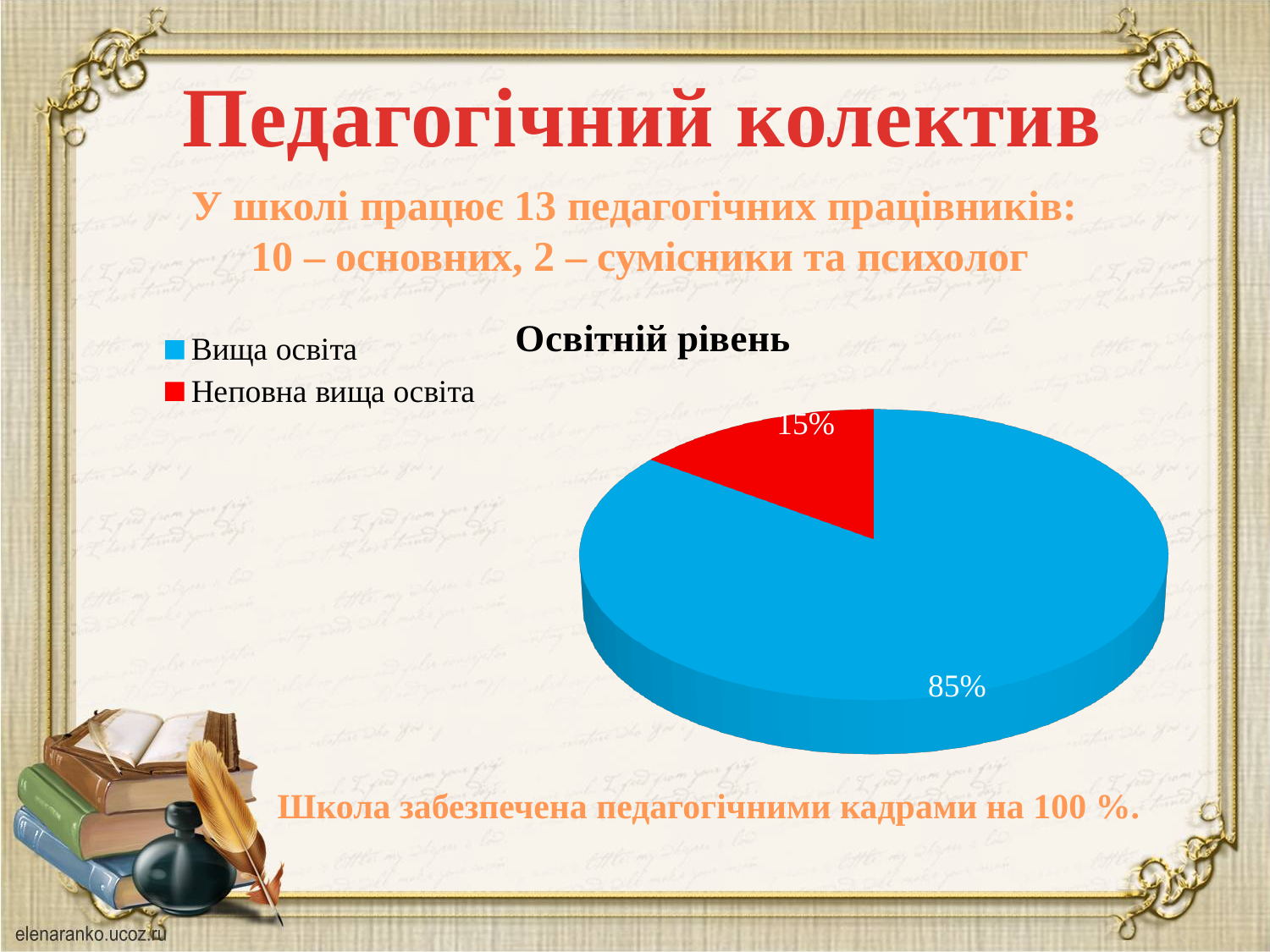
What colour is the slice for "Неповна вища освіта"? red What is the difference in percentage points between "Вища освіта" and "Неповна вища освіта"? 70 Which category has the smallest slice of the pie? Неповна вища освіта What is the title of the chart? Освітній рівень What kind of chart is shown on the slide? pie chart How many categories does the legend list? 2 What share of the pie does "Вища освіта" have? 85% Which is larger: the slice for "Вища освіта" or the slice for "Неповна вища освіта"? Вища освіта How many slices does the pie chart have? 2 What share of the pie does "Неповна вища освіта" have? 15% Which category has the largest slice of the pie? Вища освіта